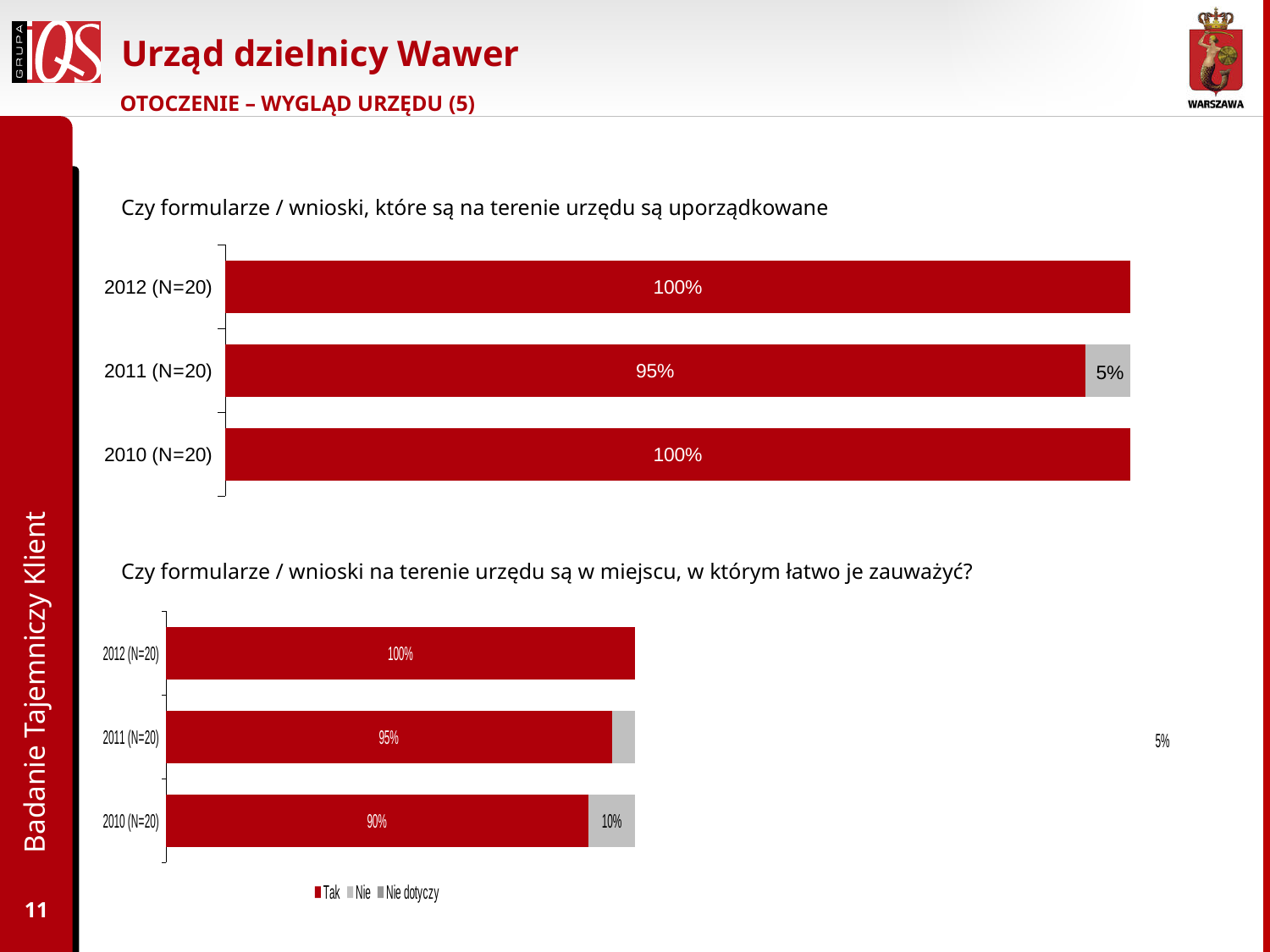
In the bottom chart (Czy formularze / wnioski na terenie urzędu są w miejscu, w którym łatwo je zauważyć?), what is the difference between the Tak values for 2012 (N=20) and 2010 (N=20)? 10% In the top chart (Czy formularze / wnioski, które są na terenie urzędu są uporządkowane), what type of chart is used? Bar chart In the bottom chart (Czy formularze / wnioski na terenie urzędu są w miejscu, w którym łatwo je zauważyć?), what is the Tak value for 2010 (N=20)? 90% In the bottom chart (Czy formularze / wnioski na terenie urzędu są w miejscu, w którym łatwo je zauważyć?), what is the Nie value for 2010 (N=20)? 10% In the bottom chart (Czy formularze / wnioski na terenie urzędu są w miejscu, w którym łatwo je zauważyć?), how many series does the legend list? 3 In the bottom chart (Czy formularze / wnioski na terenie urzędu są w miejscu, w którym łatwo je zauważyć?), what is the Tak value for 2011 (N=20)? 95% In the top chart (Czy formularze / wnioski, które są na terenie urzędu są uporządkowane), how many year categories are shown? 3 In the top chart (Czy formularze / wnioski, które są na terenie urzędu są uporządkowane), what is the value shown for 2012 (N=20)? 100% In the top chart (Czy formularze / wnioski, które są na terenie urzędu są uporządkowane), what is the value of the grey segment for 2011 (N=20)? 5% In the top chart (Czy formularze / wnioski, które są na terenie urzędu są uporządkowane), what is the value of the red segment for 2011 (N=20)? 95% In the bottom chart (Czy formularze / wnioski na terenie urzędu są w miejscu, w którym łatwo je zauważyć?), what are the legend entries? Tak, Nie, Nie dotyczy In the bottom chart (Czy formularze / wnioski na terenie urzędu są w miejscu, w którym łatwo je zauważyć?), which year has the lowest Tak value? 2010 (N=20)